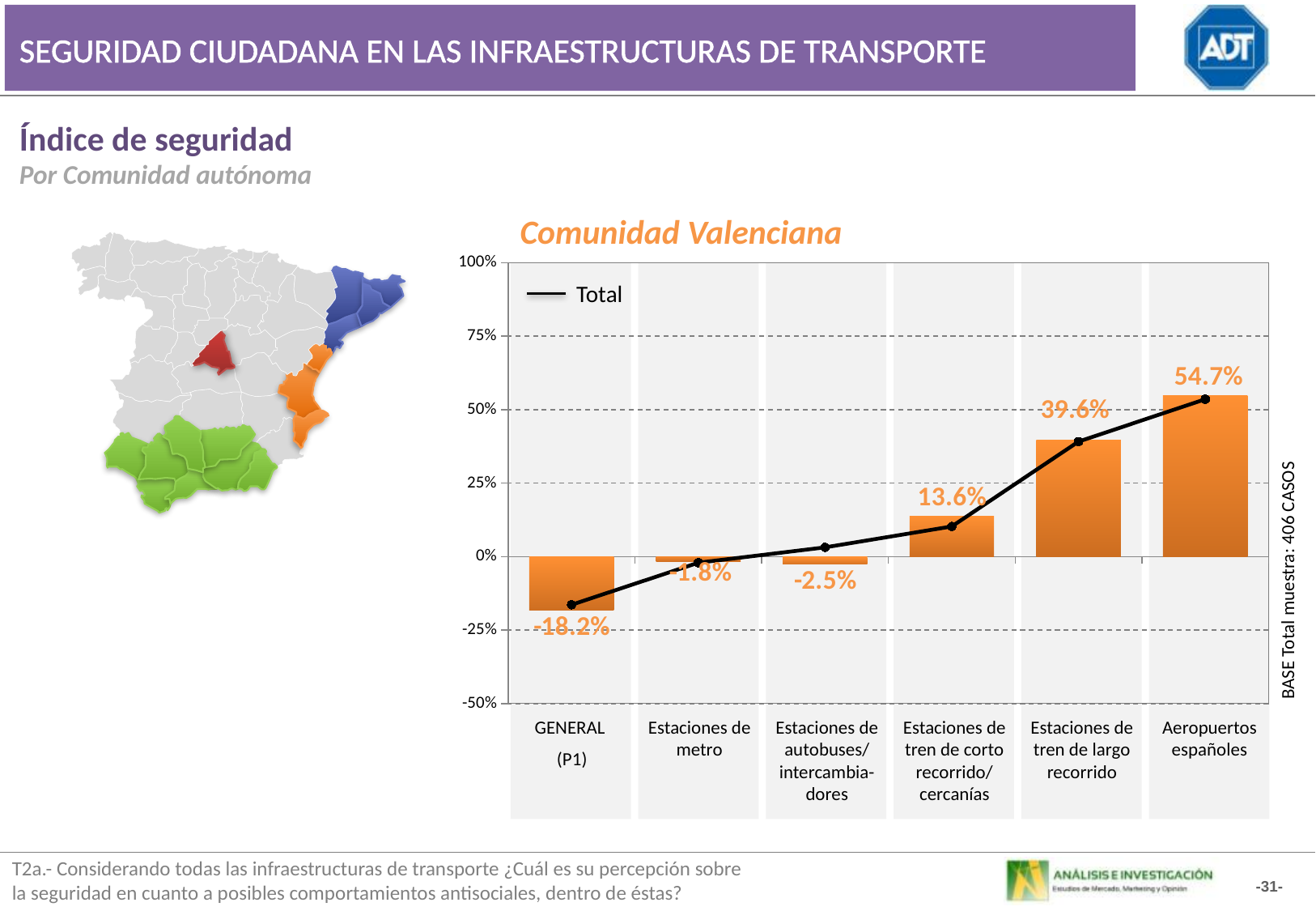
Which category has the lowest bar value in the Comunidad Valenciana chart? GENERAL (P1) How many series does the legend of the Comunidad Valenciana chart list? 1 What is the value of the bar for GENERAL (P1) in the Comunidad Valenciana chart? -18.2% Which bar value is larger: Estaciones de tren de corto recorrido/cercanías or Estaciones de autobuses/intercambiadores? Estaciones de tren de corto recorrido/cercanías Is the Total line value for Aeropuertos españoles greater or less than 50%? greater What is the value of the bar for Estaciones de metro? -1.8% Do the bar values generally rise or fall from left to right across the categories after GENERAL (P1)? rise Which category has the highest bar value in the Comunidad Valenciana chart? Aeropuertos españoles What is the difference between the bar values for Aeropuertos españoles and Estaciones de tren de largo recorrido? 15.1% What is the value of the bar for Aeropuertos españoles in the Comunidad Valenciana chart? 54.7% How many categories are shown on the x axis of the Comunidad Valenciana chart? 6 What is the value of the bar for Estaciones de tren de largo recorrido? 39.6%